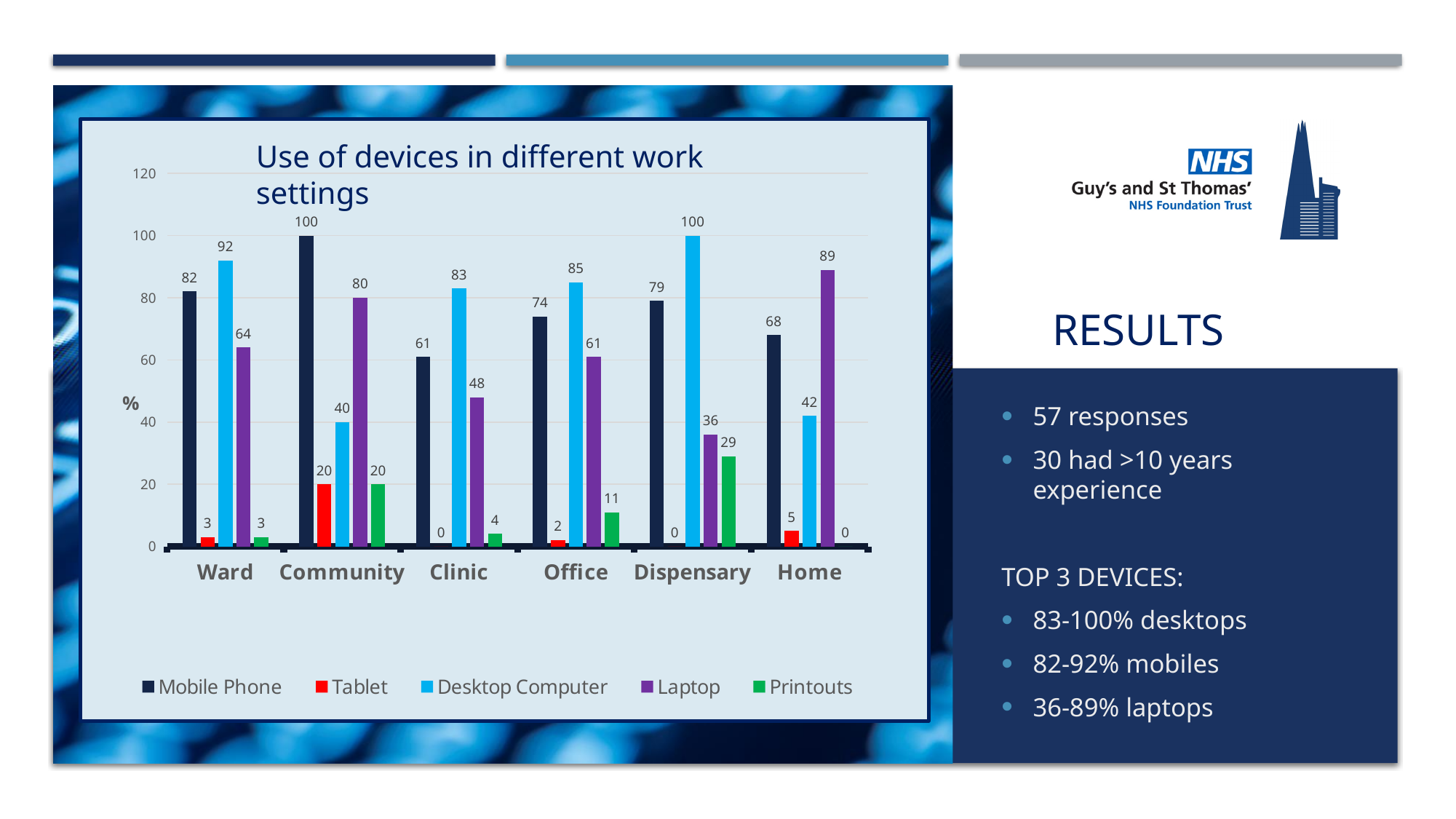
In the Office setting, which is larger: the Mobile Phone value or the Desktop Computer value? Desktop Computer What is the value for Printouts in the Dispensary setting? 29 What is the title of the chart? Use of devices in different work settings Which work setting has the highest value for Mobile Phone? Community How many series does the legend list? 5 What is the value for Desktop Computer in the Ward setting? 92 What is the value for Laptop in the Home setting? 89 What kind of chart is shown on the slide? Bar chart Which work setting has the lowest value for Laptop? Dispensary What is the difference between the Desktop Computer value and the Mobile Phone value in the Clinic setting? 22 What is the label on the y axis of the chart? % How many work settings are shown on the x axis? 6